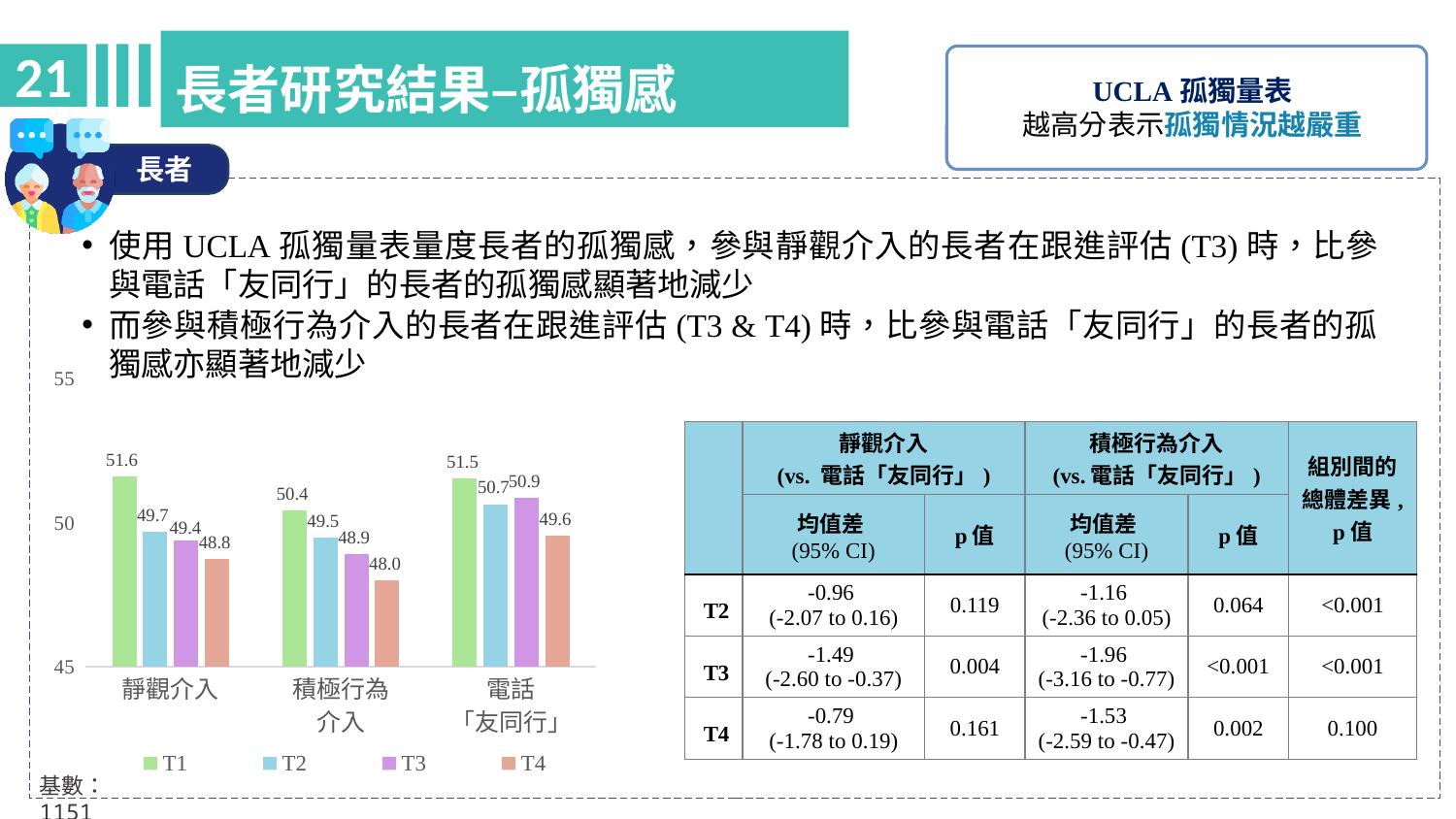
Do the values for 積極行為介入 rise or fall from T1 to T4? fall What is the difference between the T1 and T4 values for 靜觀介入? 2.8 What is the T1 value for 靜觀介入? 51.6 What is the T4 value for 積極行為介入? 48.0 How many categories are shown on the x axis? 3 What kind of chart is shown on the slide? bar chart Which is larger, the T2 value for 靜觀介入 or the T2 value for 電話「友同行」? 電話「友同行」 How many series does the legend list? 4 What is the T3 value for 電話「友同行」? 50.9 Is the T1 value for 積極行為介入 greater or less than 50? greater Which category has the highest T3 value? 電話「友同行」 Which category has the lowest T4 value? 積極行為介入